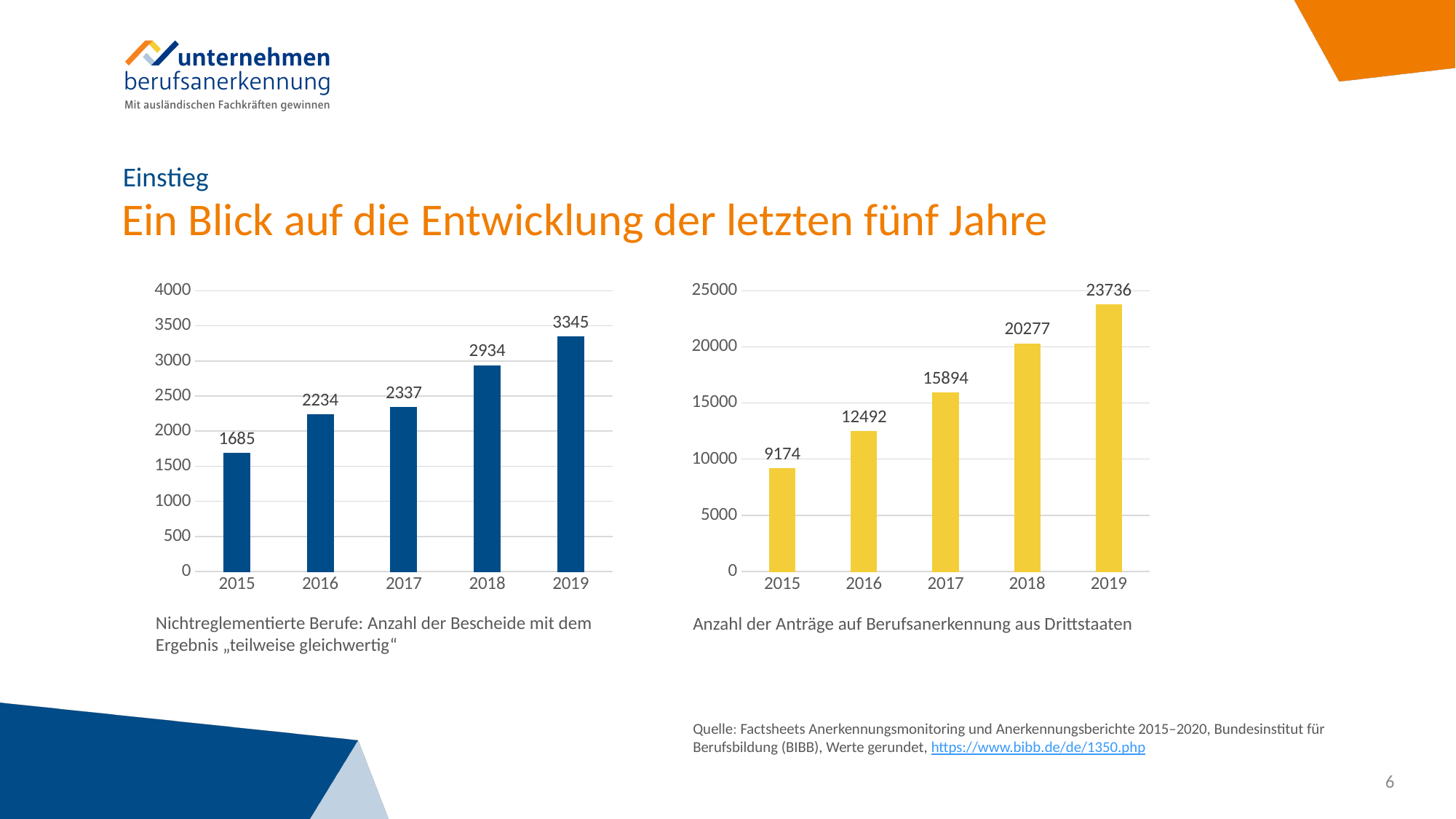
What kind of chart is the left chart? bar chart In the left chart, is the value for 2018 greater or less than 3000? less What colour are the bars in the right chart? yellow In the left chart, what is the difference between the values for 2019 and 2018? 411 In the right chart, which is larger: the value for 2017 or the value for 2016? 2017 In the right chart, do the values rise or fall from 2015 to 2019? rise In the right chart, which year has the lowest value? 2015 In the left chart (Nichtreglementierte Berufe), what is the value for 2017? 2337 In the right chart, what is the difference between the values for 2018 and 2017? 4383 In the right chart (Anzahl der Anträge auf Berufsanerkennung aus Drittstaaten), what is the value for 2016? 12492 How many years are shown on the x axis of the right chart? 5 In the left chart, which year has the highest value? 2019